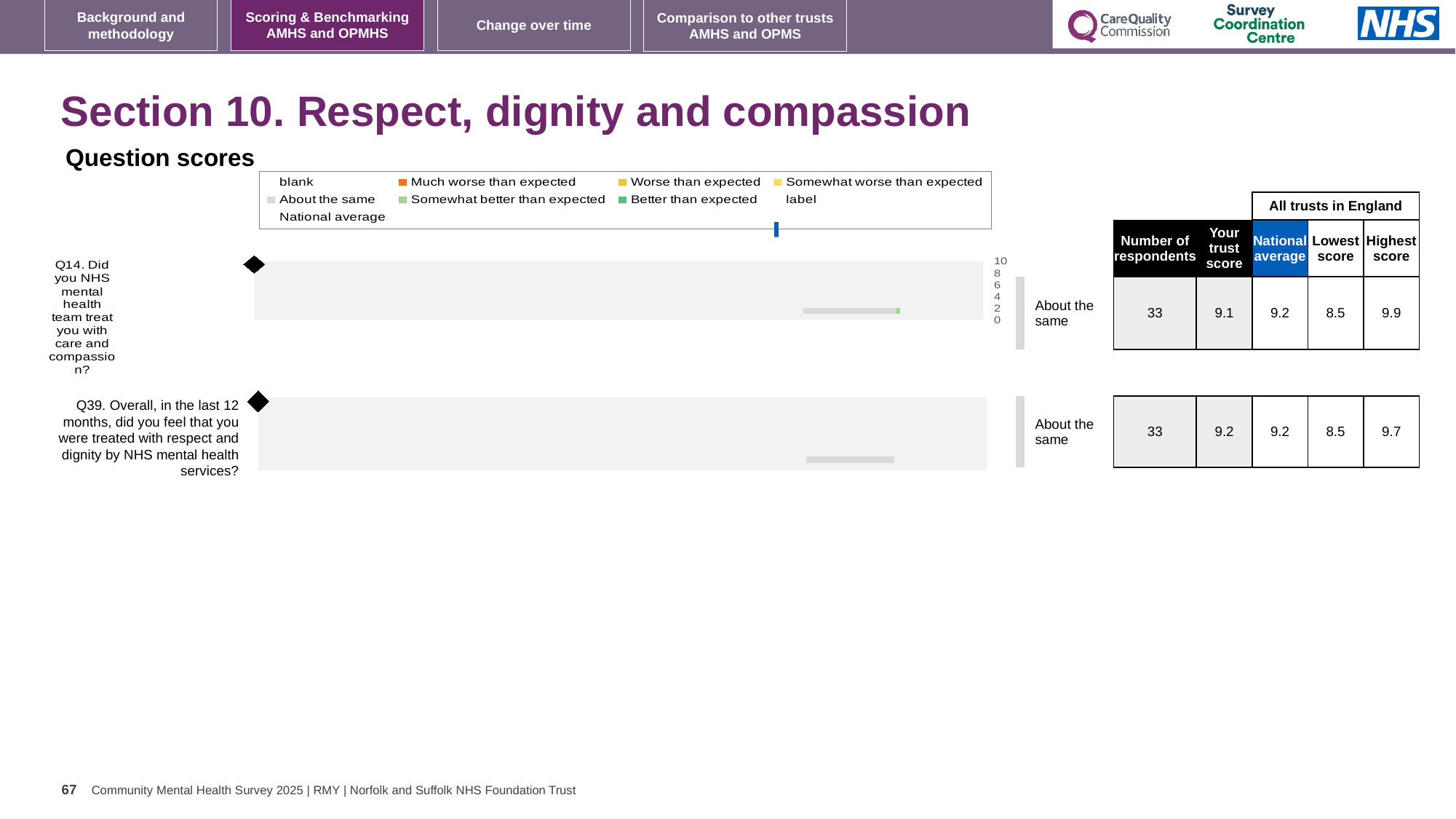
What benchmark category is shown for Q39? About the same How many questions are shown in the Question scores charts? 2 What is the lowest score among all trusts in England for Q39? 8.5 What is the difference between the highest score and the lowest score for Q14? 1.4 What is the highest score among all trusts in England for Q14? 9.9 How many respondents answered Q14? 33 What is the trust score for Q14 (Did your NHS mental health team treat you with care and compassion?)? 9.1 Which question has the higher trust score, Q14 or Q39? Q39 What kind of chart is used for the question scores? Bar chart What is the highest score among all trusts in England for Q39? 9.7 What is the national average score for Q14? 9.2 What is the trust score for Q39 (treated with respect and dignity by NHS mental health services)? 9.2